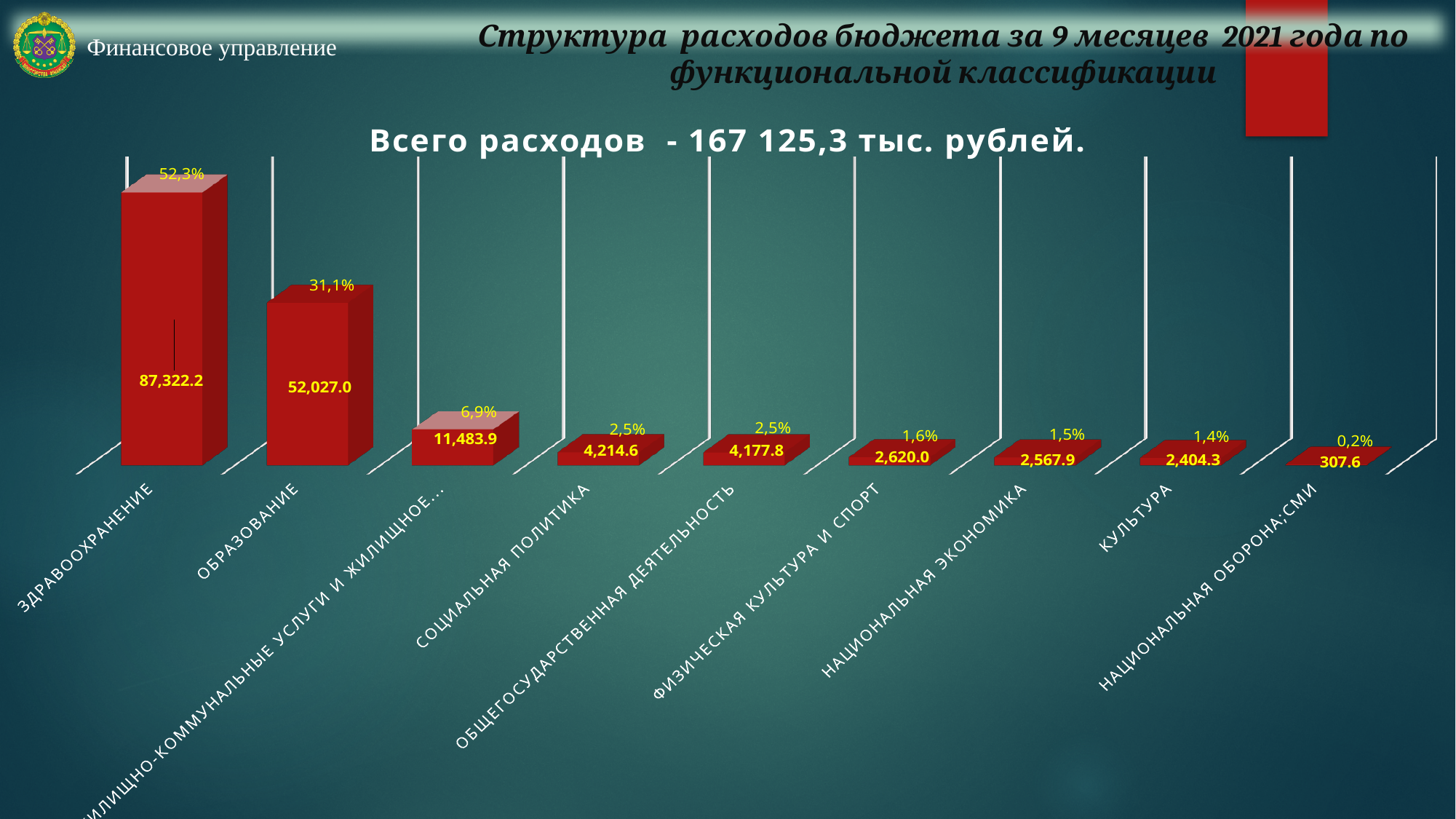
Which category has the lowest value? НАЦИОНАЛЬНАЯ ОБОРОНА;СМИ What is the value shown for ОБРАЗОВАНИЕ? 52,027.0 What is the value shown for ЗДРАВООХРАНЕНИЕ? 87,322.2 Do the values rise or fall from left to right along the x axis? Fall What percentage label is shown above the bar for СОЦИАЛЬНАЯ ПОЛИТИКА? 2,5% What kind of chart is shown on the slide? Bar chart Which has the larger value, СОЦИАЛЬНАЯ ПОЛИТИКА or ОБЩЕГОСУДАРСТВЕННАЯ ДЕЯТЕЛЬНОСТЬ? СОЦИАЛЬНАЯ ПОЛИТИКА What is the difference between the values for ЗДРАВООХРАНЕНИЕ and ОБРАЗОВАНИЕ? 35,295.2 What is the value shown for КУЛЬТУРА? 2,404.3 What is the difference between the values for ФИЗИЧЕСКАЯ КУЛЬТУРА И СПОРТ and НАЦИОНАЛЬНАЯ ЭКОНОМИКА? 52.1 How many categories are shown in the chart? 9 Which category has the highest value? ЗДРАВООХРАНЕНИЕ